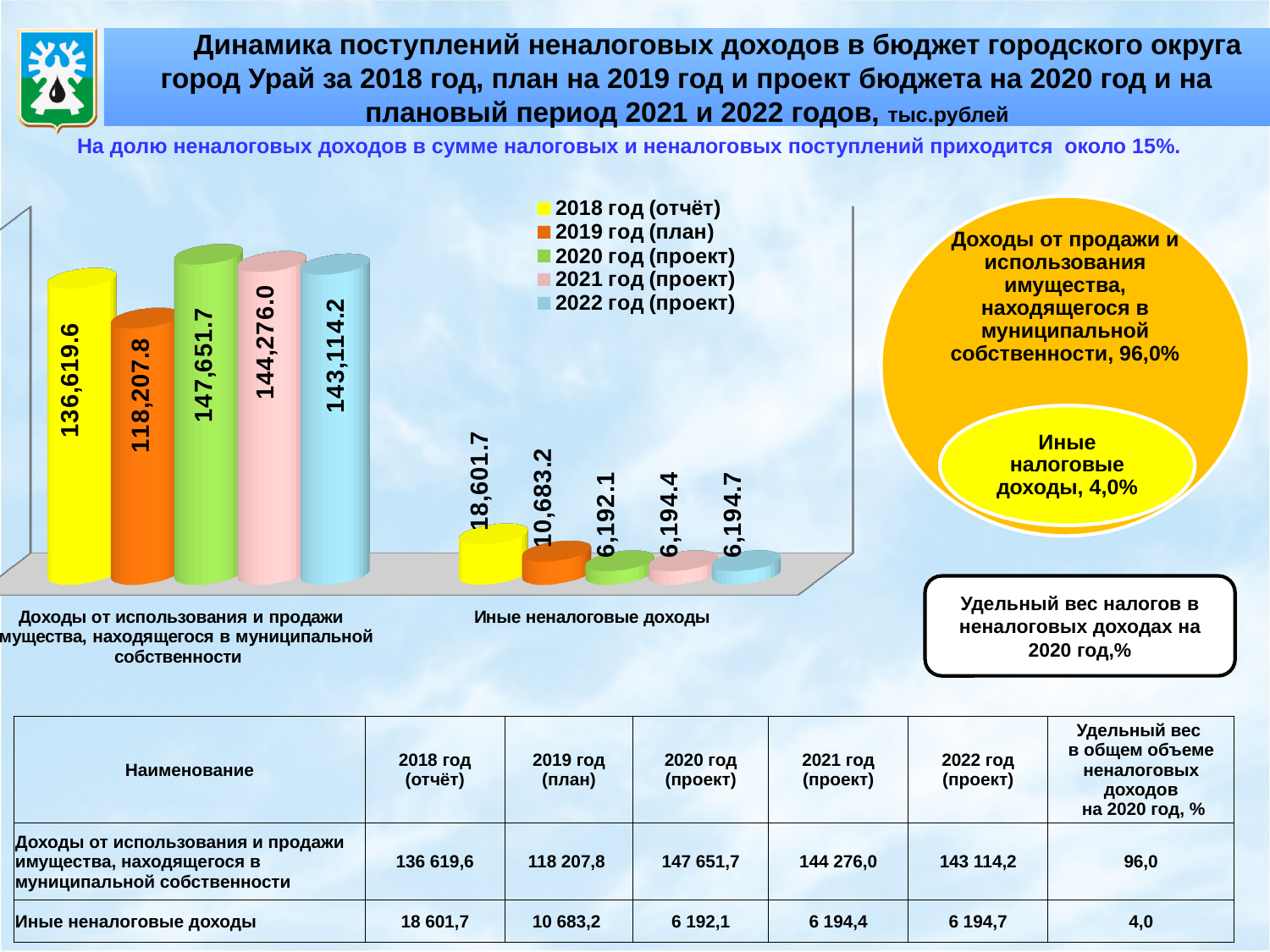
How many categories are shown on the x axis of the bar chart? 2 In the circle diagram on the right, what share is shown for 'Доходы от продажи и использования имущества, находящегося в муниципальной собственности'? 96,0% In the bar chart, what is the difference between the 2020 год (проект) and 2018 год (отчёт) values for 'Доходы от использования и продажи имущества, находящегося в муниципальной собственности'? 11,032.1 In the bar chart, what is the difference between the 2018 год (отчёт) and 2019 год (план) values for 'Иные неналоговые доходы'? 7,918.5 In the bar chart, what is the value for 'Иные неналоговые доходы' in the '2022 год (проект)' series? 6,194.7 In the bar chart, which series has the lowest value for 'Доходы от использования и продажи имущества, находящегося в муниципальной собственности'? 2019 год (план) In the bar chart, which is larger for 'Доходы от использования и продажи имущества, находящегося в муниципальной собственности': the 2021 год (проект) value or the 2022 год (проект) value? 2021 год (проект) In the bar chart, which series has the highest value for 'Доходы от использования и продажи имущества, находящегося в муниципальной собственности'? 2020 год (проект) In the bar chart, which series has the highest value for 'Иные неналоговые доходы'? 2018 год (отчёт) How many series does the legend of the bar chart list? 5 In the bar chart, what is the value for 'Иные неналоговые доходы' in the '2019 год (план)' series? 10,683.2 In the bar chart, what is the value for 'Доходы от использования и продажи имущества, находящегося в муниципальной собственности' in the '2018 год (отчёт)' series? 136,619.6